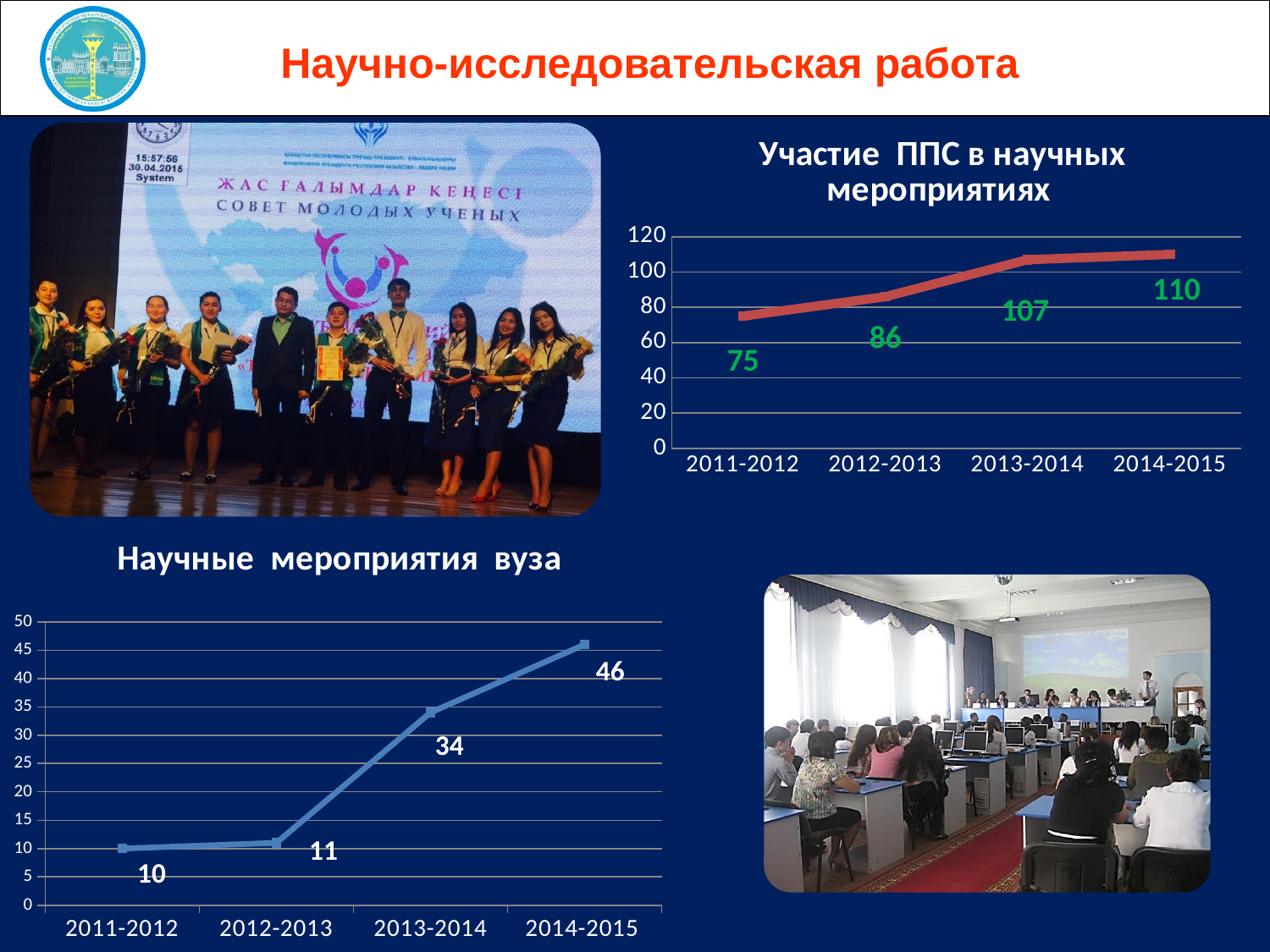
In the chart 'Научные мероприятия вуза', what is the value for 2014-2015? 46 In the chart 'Участие ППС в научных мероприятиях', what is the value for 2011-2012? 75 In the chart 'Научные мероприятия вуза', how many periods are plotted on the x axis? 4 In the chart 'Научные мероприятия вуза', is the value for 2012-2013 greater or less than 20? less In the chart 'Участие ППС в научных мероприятиях', which period has the highest value? 2014-2015 In the chart 'Научные мероприятия вуза', what is the value for 2013-2014? 34 In the chart 'Участие ППС в научных мероприятиях', what is the value for 2013-2014? 107 In the chart 'Участие ППС в научных мероприятиях', what is the difference between the values for 2014-2015 and 2011-2012? 35 What type of chart is 'Участие ППС в научных мероприятиях'? line chart In the chart 'Участие ППС в научных мероприятиях', do the values rise or fall from 2011-2012 to 2014-2015? rise In the chart 'Научные мероприятия вуза', what is the difference between the values for 2013-2014 and 2012-2013? 23 In the chart 'Научные мероприятия вуза', which period has the lowest value? 2011-2012